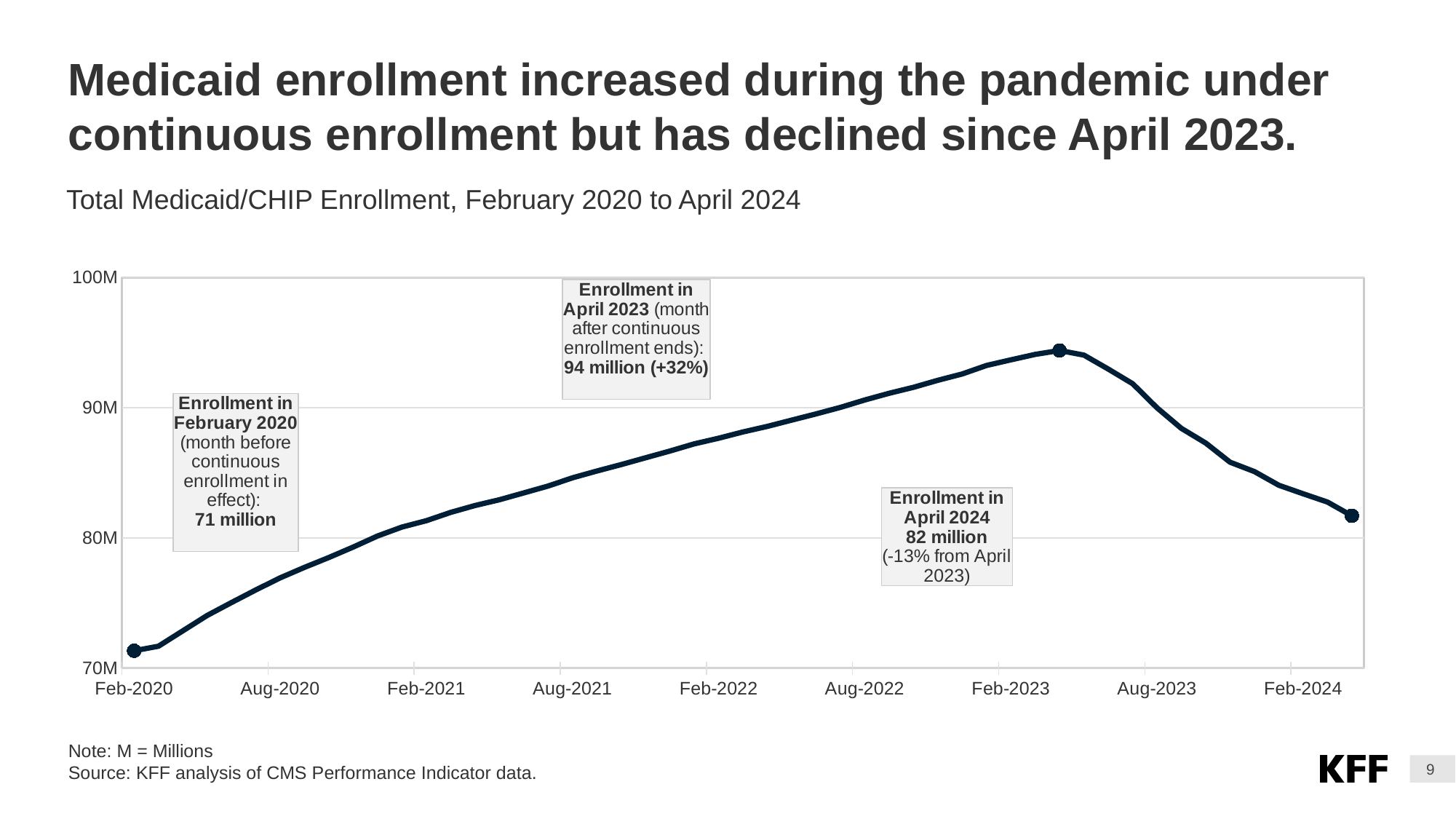
Which of the three annotated months had the lowest enrollment? February 2020 What is the difference in enrollment between April 2023 and April 2024? 12 million Was enrollment higher in April 2024 or in February 2020? April 2024 Does enrollment rise or fall between Feb-2020 and Feb-2023? Rise Is the enrollment value for Feb-2022 greater or less than 80M? greater Which of the three annotated months had the highest enrollment? April 2023 What was total Medicaid/CHIP enrollment in February 2020? 71 million What was total Medicaid/CHIP enrollment in April 2023? 94 million By what percentage did enrollment change from February 2020 to April 2023, according to the annotation? +32% What was total Medicaid/CHIP enrollment in April 2024? 82 million What kind of chart is shown on the slide? Line chart By what percentage did enrollment change from April 2023 to April 2024, according to the annotation? -13%